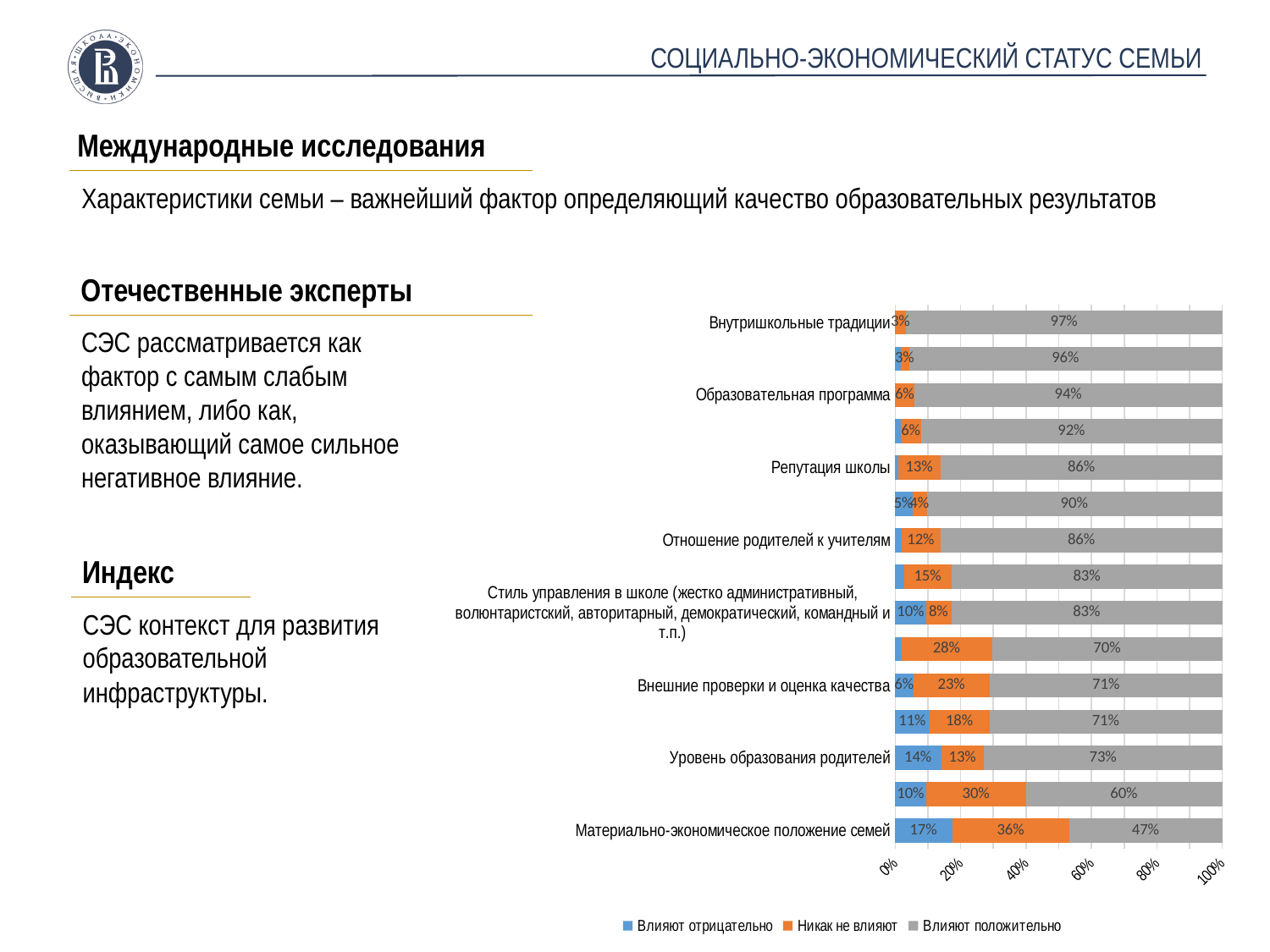
What is the total of the stacked bar for 'Материально-экономическое положение семей'? 100% Which has the larger 'Никак не влияют' value: 'Внешние проверки и оценка качества' or 'Уровень образования родителей'? Внешние проверки и оценка качества What is the value of 'Влияют положительно' for 'Внутришкольные традиции'? 97% Which labeled category has the highest 'Влияют положительно' value? Внутришкольные традиции What is the value of 'Влияют положительно' for 'Материально-экономическое положение семей'? 47% What is the value of 'Влияют положительно' for 'Стиль управления в школе'? 83% What kind of chart is shown on the slide? Stacked horizontal bar chart How many series does the legend list? 3 What is the difference between the 'Влияют положительно' values for 'Внутришкольные традиции' and 'Материально-экономическое положение семей'? 50 percentage points What is the value of 'Никак не влияют' for 'Материально-экономическое положение семей'? 36% What is the value of 'Влияют отрицательно' for 'Уровень образования родителей'? 14% Which labeled category has the lowest 'Влияют положительно' value? Материально-экономическое положение семей